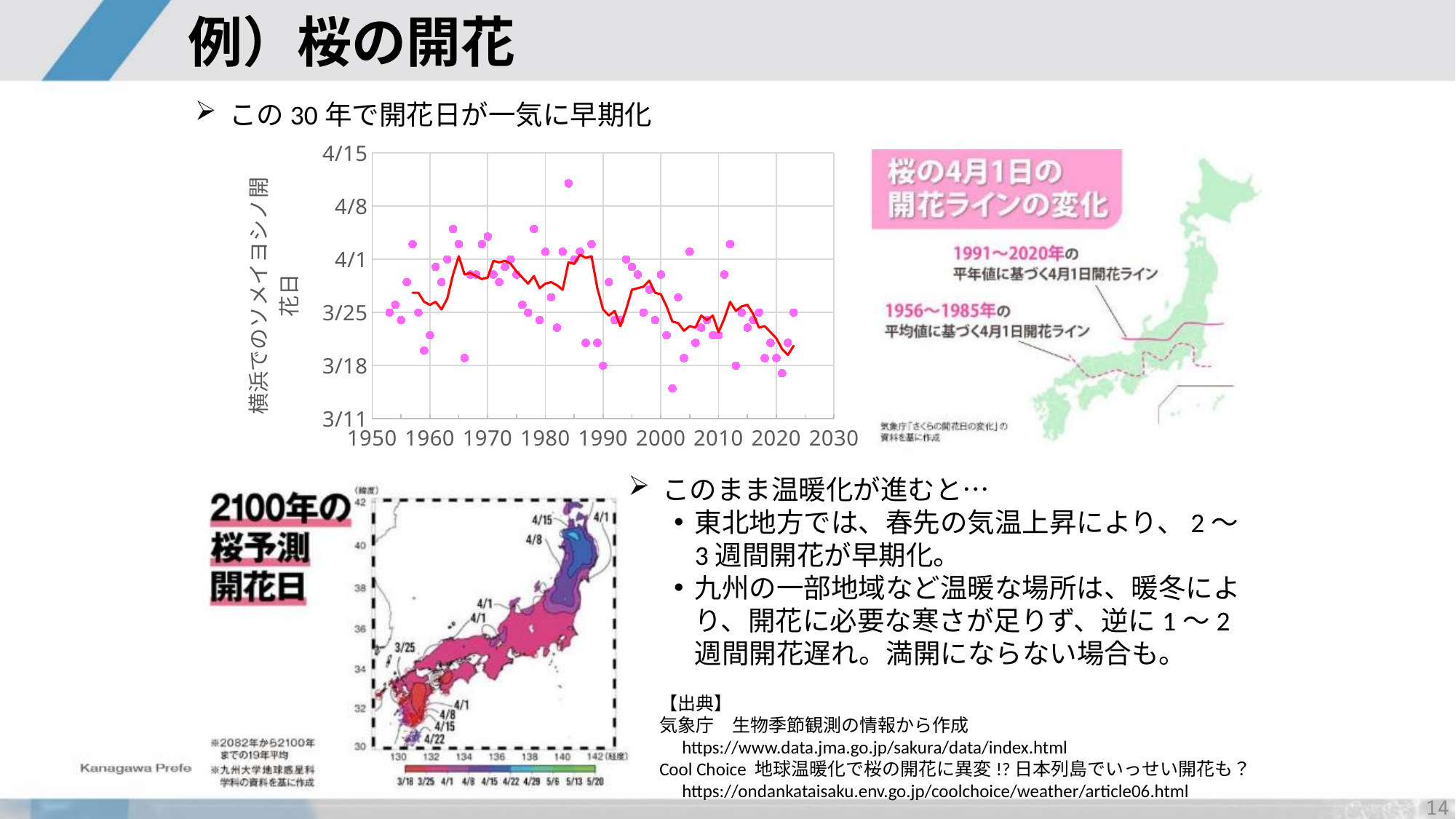
What kind of chart is the chart on the left showing Yokohama cherry blossom flowering dates? scatter chart In the Yokohama flowering date chart, is the red line around 1985 above or below 3/25? above In the Yokohama flowering date chart, is the lowest plotted point greater or less than 3/18? less What are the first and last year ticks on the horizontal axis of the Yokohama flowering date chart? 1950 and 2030 In the Yokohama flowering date chart, is the highest plotted point greater or less than 4/8? greater In the Yokohama flowering date chart, is the red line higher around 1965 or around 2020? around 1965 What is the label of the vertical axis of the Yokohama flowering date chart? 横浜でのソメイヨシノ開花日 In the Yokohama flowering date chart, do the flowering dates generally become earlier or later from 1950 to 2020? earlier